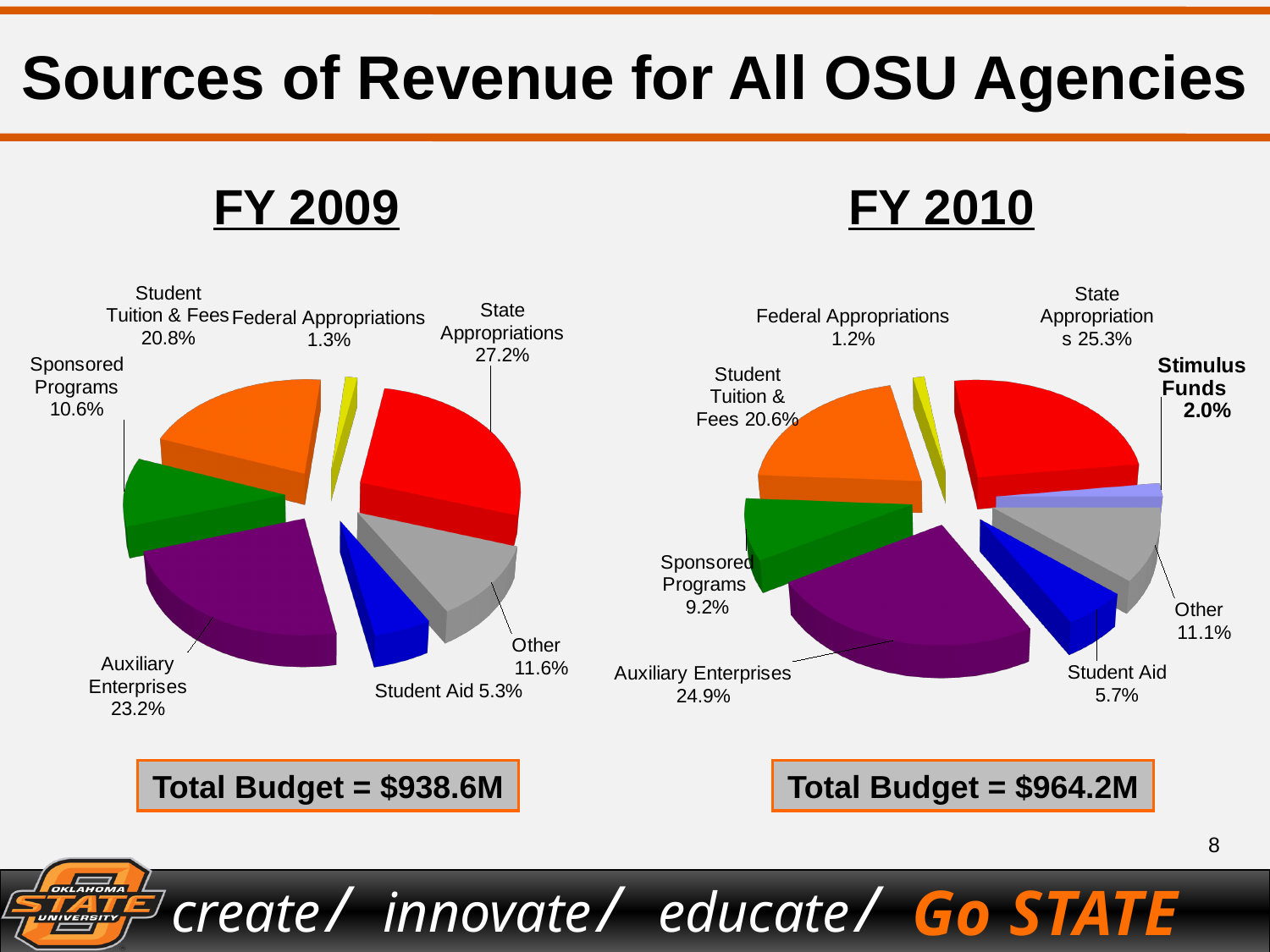
What type of chart is used for FY 2009? Pie chart In the FY 2009 chart, which source has the smallest share of revenue? Federal Appropriations In the FY 2009 chart, what is the difference between the Auxiliary Enterprises share and the Student Tuition & Fees share? 2.4% How many slices does the FY 2010 pie chart have? 8 How many slices does the FY 2009 pie chart have? 7 In the FY 2009 chart, what share of revenue comes from State Appropriations? 27.2% What is the total budget shown below the FY 2010 chart? $964.2M In the FY 2010 chart, what share of revenue comes from Stimulus Funds? 2.0% In the FY 2010 chart, what share of revenue comes from Auxiliary Enterprises? 24.9% In the FY 2010 chart, which is larger: the share for Sponsored Programs or the share for Other? Other In the FY 2010 chart, which source has the smallest share of revenue? Federal Appropriations In the FY 2009 chart, which source has the largest share of revenue? State Appropriations